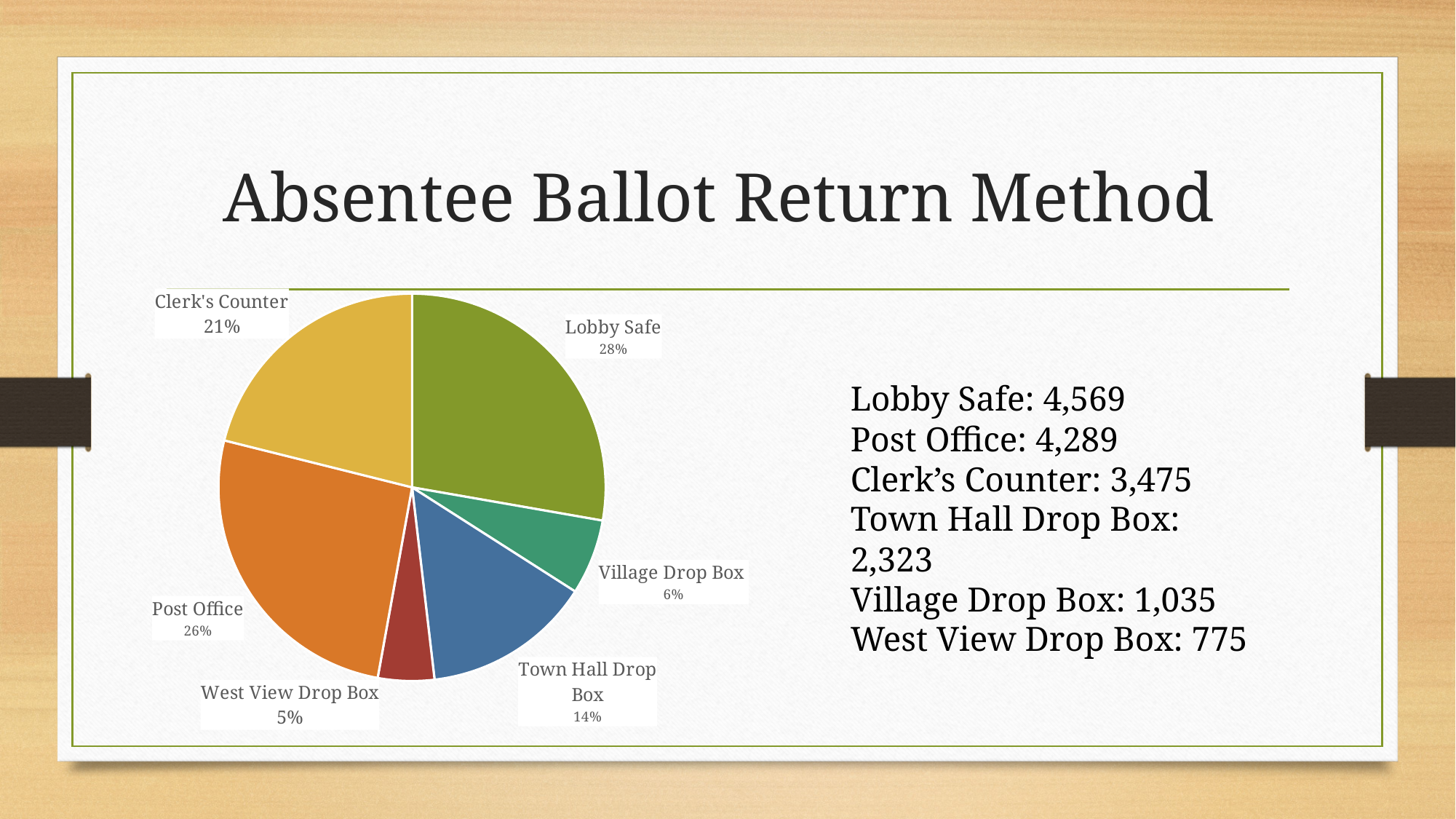
What is the difference in percentage points between Lobby Safe and West View Drop Box? 23 What colour is the Post Office slice? Orange What is the difference in percentage points between Clerk's Counter and Village Drop Box? 15 Which return method has the smallest slice of the pie? West View Drop Box Which return method has the largest slice of the pie? Lobby Safe How many categories are shown in the pie chart? 6 What kind of chart is shown on the slide? Pie chart What share of the pie does Lobby Safe represent? 28% What is the title of the slide containing the chart? Absentee Ballot Return Method Which is larger, the Post Office slice or the Clerk's Counter slice? Post Office What percentage is shown for Town Hall Drop Box? 14% What percentage is shown for Post Office? 26%